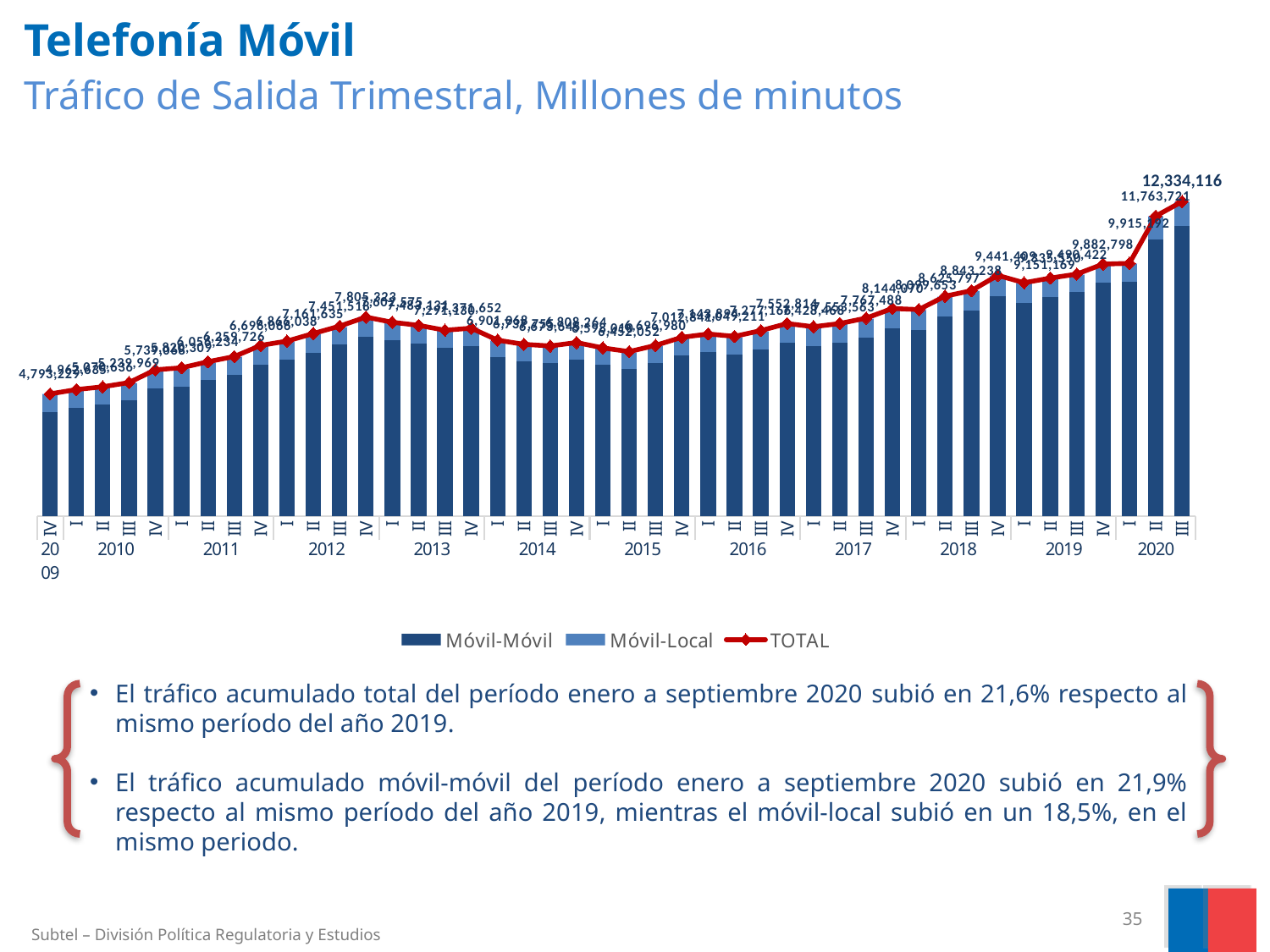
What is the difference between the TOTAL values for quarter III of 2020 and quarter II of 2020? 570,395 How many series does the legend list? 3 What is the TOTAL value for quarter IV of 2019? 9,882,798 What are the three entries in the chart legend? Móvil-Móvil, Móvil-Local, TOTAL What is the TOTAL value for quarter IV of 2009? 4,793,229 Which quarter has the highest TOTAL value? III 2020 Which quarter has the lowest TOTAL value? IV 2009 Which has a larger TOTAL value, quarter IV of 2012 or quarter IV of 2013? IV 2012 What is the TOTAL value for quarter II of 2020? 11,763,721 What kind of chart is shown on the slide? Stacked bar chart with a line Does the TOTAL line generally rise or fall from 2009 to 2020? Rise What is the TOTAL value for quarter III of 2020? 12,334,116